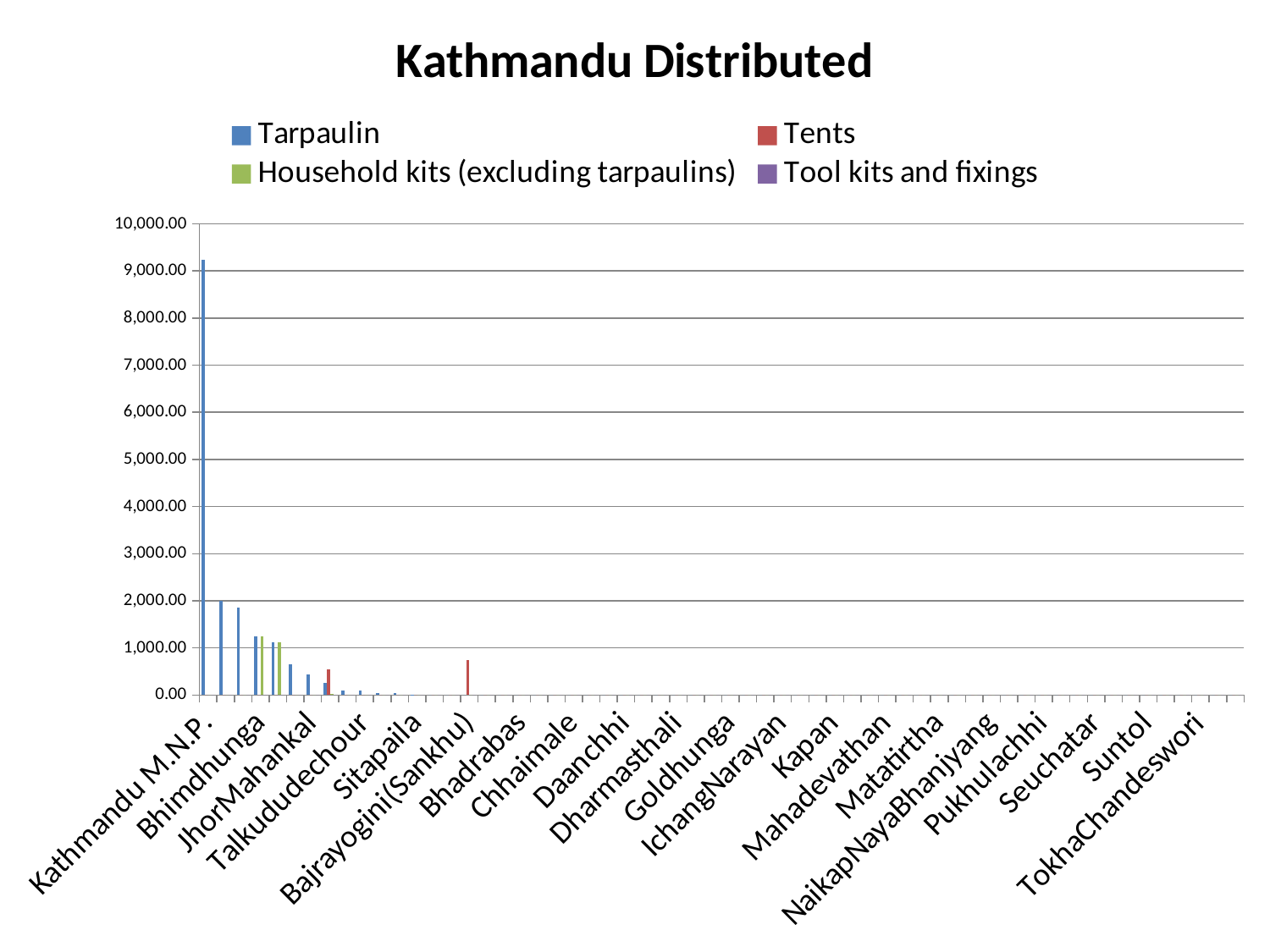
Is the Tents value for Bajrayogini(Sankhu) greater or less than 1,000? less Is the Tarpaulin value for Bhimdhunga greater or less than 1,000? greater What kind of chart is shown on the slide? bar chart Which category has the highest Tarpaulin value? Kathmandu M.N.P. Which series is shown in green in the legend? Household kits (excluding tarpaulins) What is the title of the chart? Kathmandu Distributed Is the Tarpaulin value for Kathmandu M.N.P. greater or less than 9,000? greater Which is larger, the Tarpaulin value for Kathmandu M.N.P. or the Tarpaulin value for Bhimdhunga? Kathmandu M.N.P. Do the Tarpaulin values generally rise or fall moving from left to right along the x axis? fall How many series does the legend list? 4